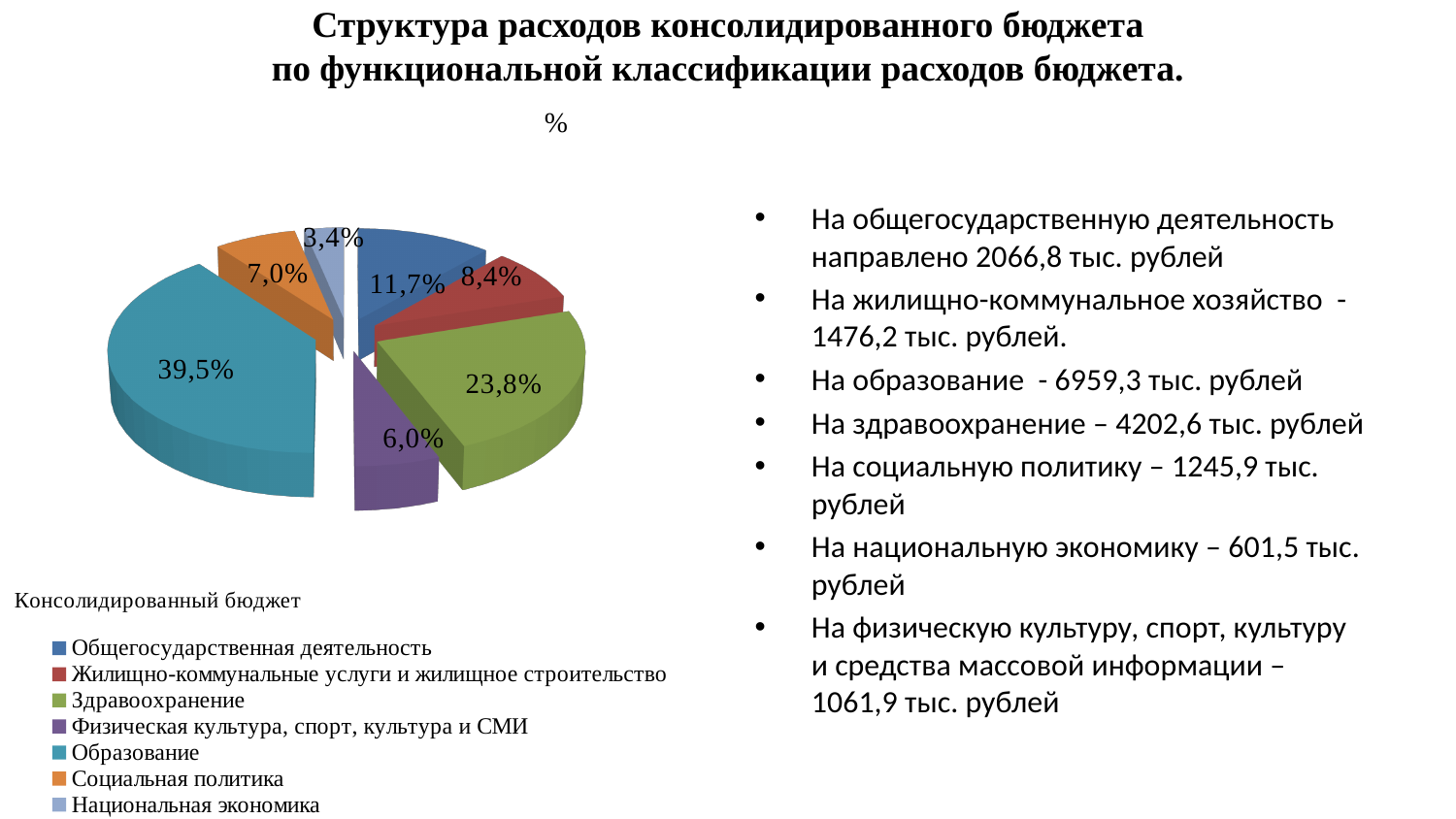
What kind of chart is shown on the slide? Pie chart Which category has the largest slice of the pie? Образование Which category has the smallest slice of the pie? Национальная экономика What share of the pie does Общегосударственная деятельность have? 11,7% What share of the pie does Образование have? 39,5% Which is larger: the slice for Жилищно-коммунальные услуги и жилищное строительство or the slice for Физическая культура, спорт, культура и СМИ? Жилищно-коммунальные услуги и жилищное строительство What is the title shown above the pie chart? % What share of the pie does Социальная политика have? 7,0% What share of the pie does Национальная экономика have? 3,4% How many categories does the legend of the pie chart list? 7 What share of the pie does Здравоохранение have? 23,8% What is the difference in percentage points between Образование and Здравоохранение? 15,7